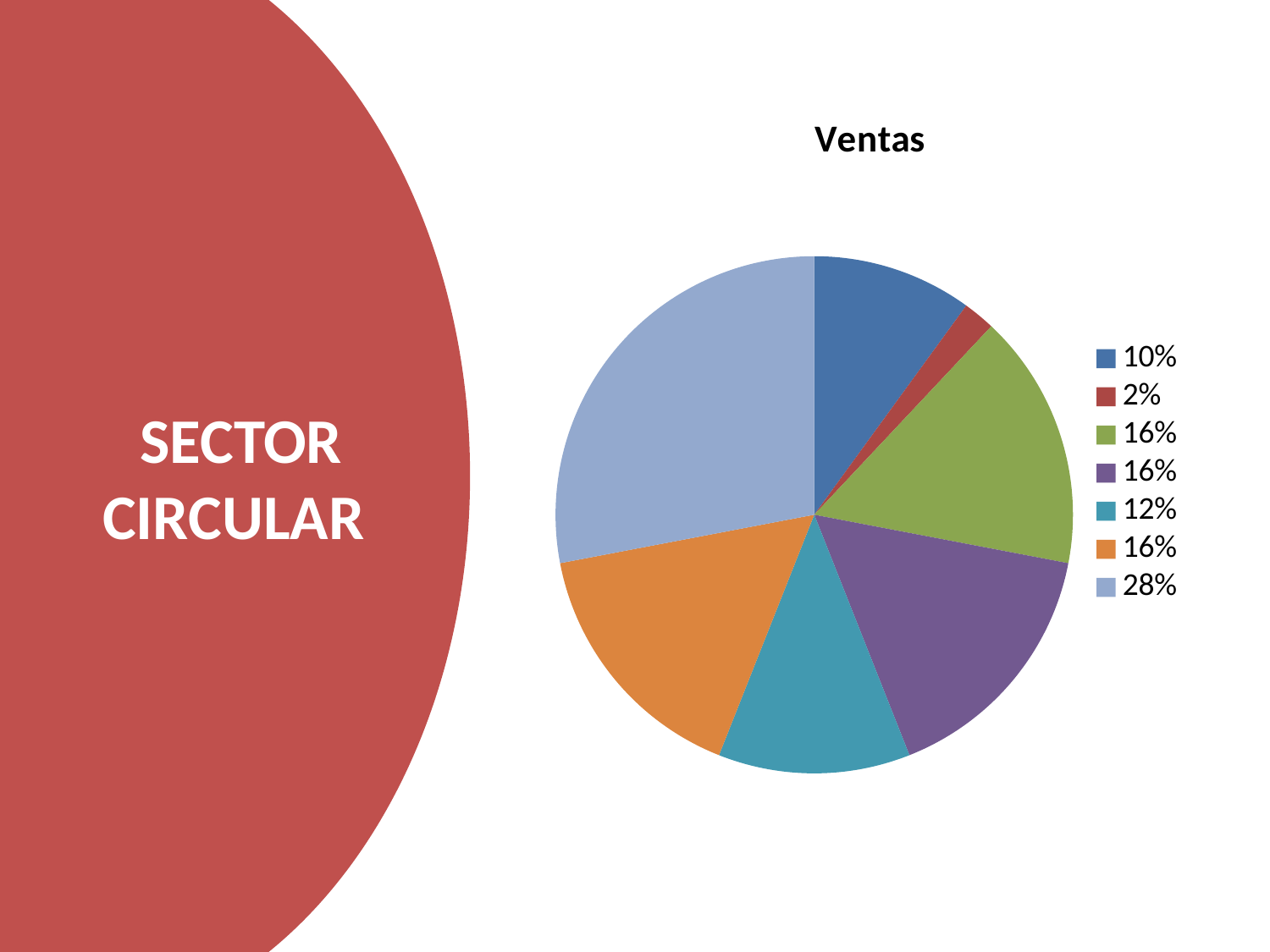
What colour is the 28% slice in the pie chart? light blue What is the share of the largest slice in the pie chart? 28% What is the title of the pie chart? Ventas How many slices does the pie chart have? 7 What is the difference between the largest slice (28%) and the smallest slice (2%)? 26% Is the share of the largest slice greater or less than 25%? greater How many legend entries show a value of 16%? 3 What is the share of the smallest slice in the pie chart? 2% What is the total of all the percentages listed in the legend? 100% What share does the red slice represent? 2% What kind of chart is shown on the slide? pie chart Is the light blue slice larger or smaller than the orange slice? larger